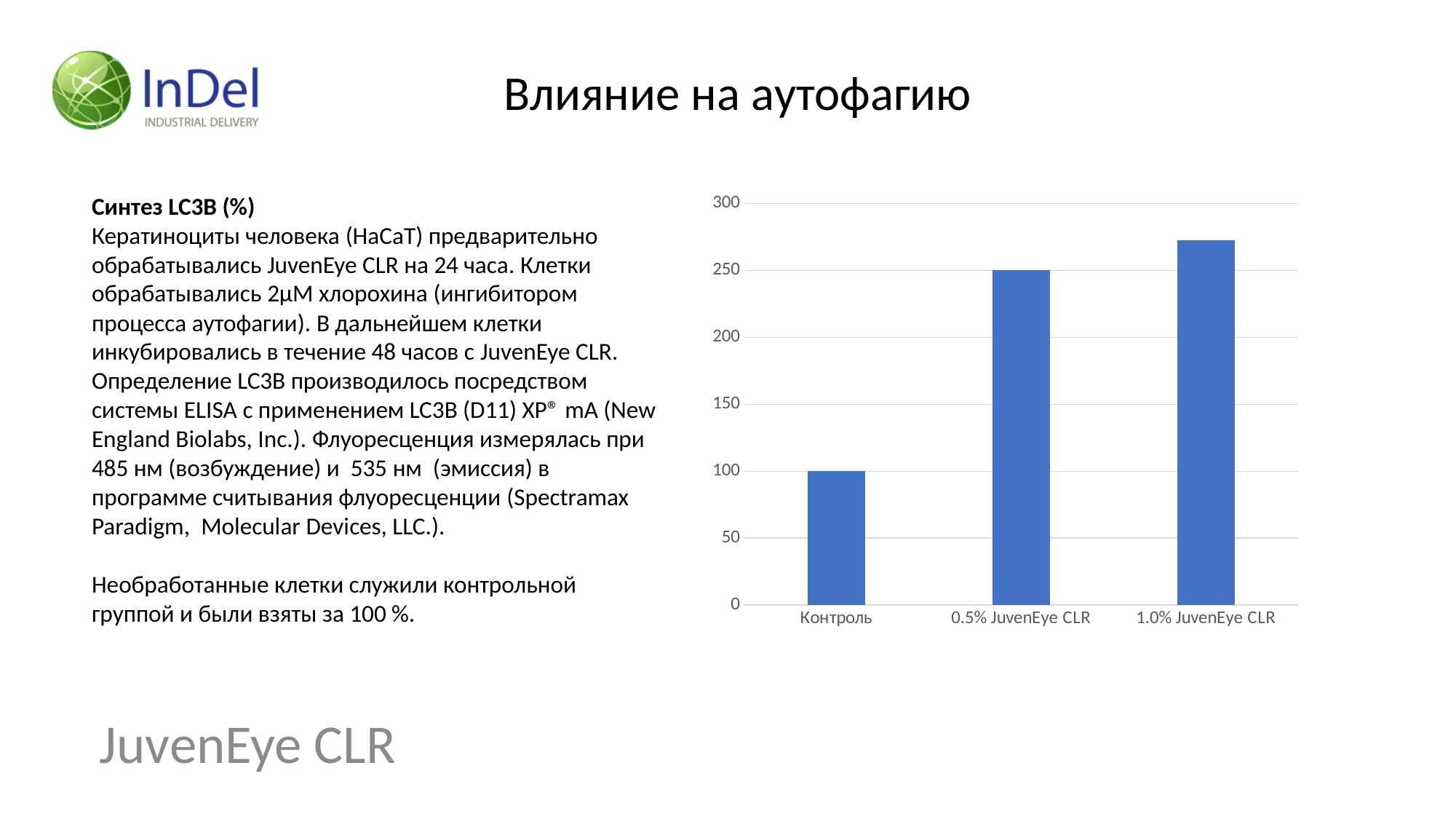
Do the bar values rise or fall from left to right across the categories? rise What is the highest value shown on the vertical axis of the chart? 300 Which is larger, the value for Контроль or the value for 0.5% JuvenEye CLR? 0.5% JuvenEye CLR What is the difference between the values for 0.5% JuvenEye CLR and Контроль? 150 What is the value for Контроль in the bar chart? 100 Which category has the lowest bar in the chart? Контроль How many categories are plotted in the bar chart? 3 Is the value for 1.0% JuvenEye CLR greater or less than 250? greater Which category has the highest bar in the chart? 1.0% JuvenEye CLR What is the value for 0.5% JuvenEye CLR in the bar chart? 250 Is the value for 1.0% JuvenEye CLR greater or less than 300? less What kind of chart is shown on the slide? bar chart